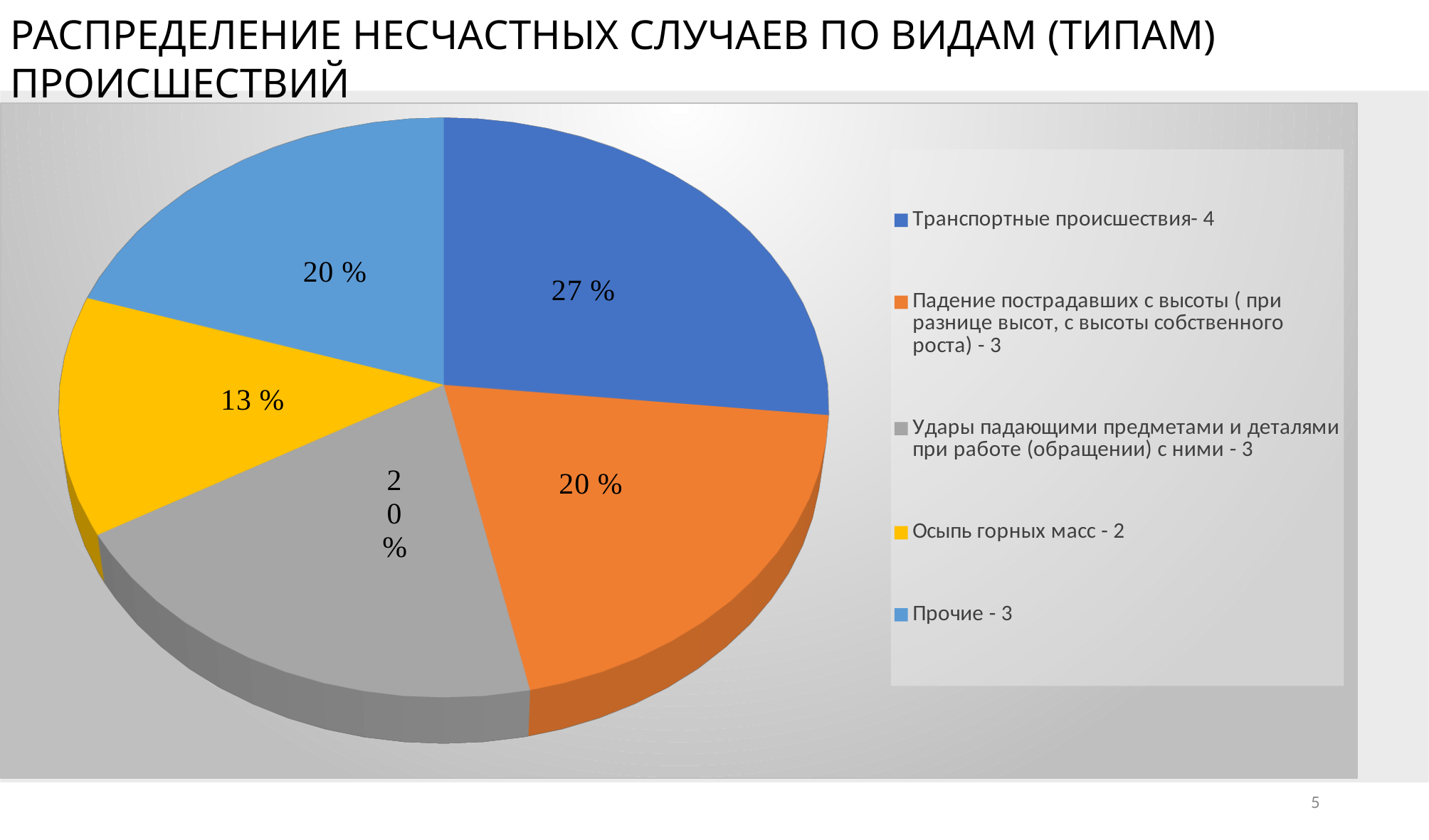
According to the legend, how many cases are listed for Транспортные происшествия? 4 What percentage of the pie is labelled for Транспортные происшествия? 27 % How many slices does the pie chart have? 5 Which category has the largest slice of the pie? Транспортные происшествия Which category has the smallest slice of the pie? Осыпь горных масс What percentage of the pie is labelled for Осыпь горных масс? 13 % What type of chart is shown on the slide? pie chart What is the difference in percentage points between the Транспортные происшествия slice and the Осыпь горных масс slice? 14 What colour is the slice for Осыпь горных масс? yellow Which slice is larger: Транспортные происшествия or Осыпь горных масс? Транспортные происшествия According to the legend, how many cases are listed for Осыпь горных масс? 2 What percentage of the pie is labelled for Прочие? 20 %